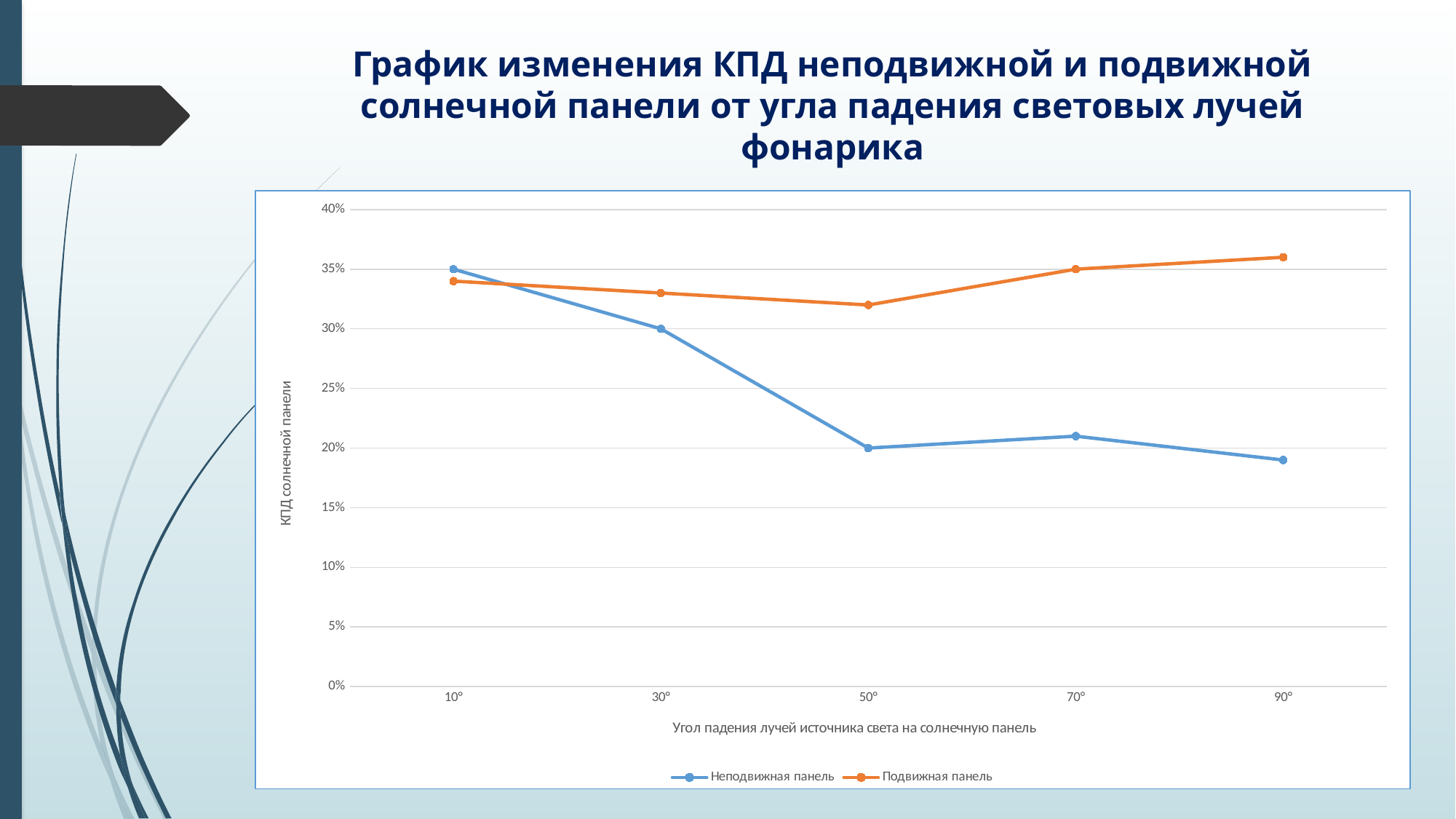
What is the value for Неподвижная панель at 50°? 20% What is the value for Неподвижная панель at 10°? 35% At which angle is the value for Подвижная панель highest? 90° What kind of chart is shown on the slide? line chart Is the value for Неподвижная панель at 90° greater or less than 20%? less What is the value for Подвижная панель at 70°? 35% At which angle is the value for Неподвижная панель lowest? 90° How many series does the legend list? 2 Is the value for Подвижная панель at 90° greater or less than 35%? greater At 50°, which series has the larger value, Неподвижная панель or Подвижная панель? Подвижная панель How many angle values are plotted along the x axis? 5 What is the value for Неподвижная панель at 30°? 30%